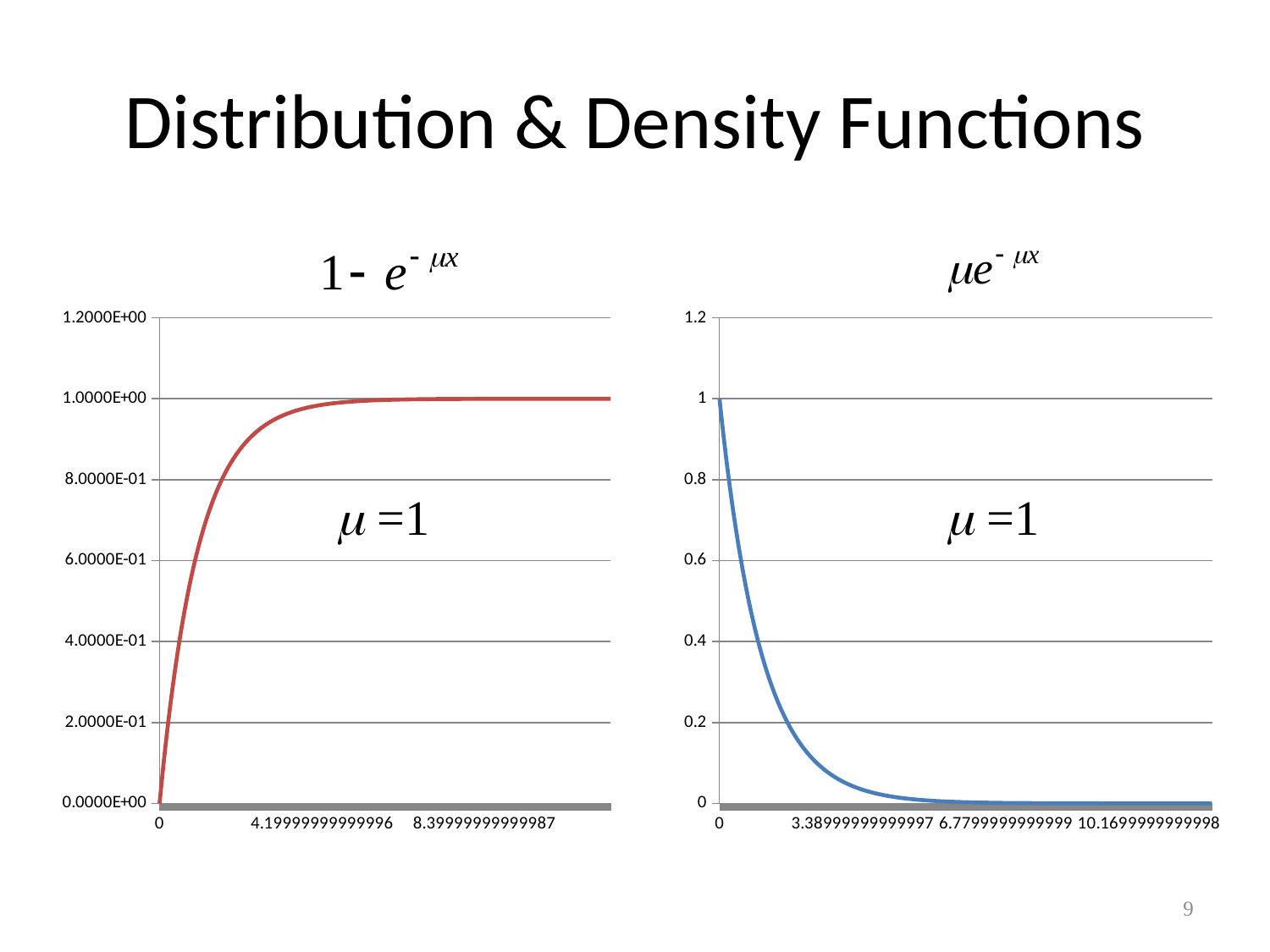
In the left chart titled 1 - e^(-μx), is the value at x = 8.39999999999987 greater or less than 8.0000E-01? greater In the right chart titled μe^(-μx), is the value at x = 6.7799999999999 greater or less than 0.2? less What value of μ is stated on both charts? μ = 1 What kind of chart is the left chart titled 1 - e^(-μx)? line chart In the left chart titled 1 - e^(-μx), do the values rise or fall as x increases? rise What is the highest value shown on the y axis of the right chart titled μe^(-μx)? 1.2 In the left chart titled 1 - e^(-μx), what is the value of the line at x = 0? 0.0000E+00 In the right chart titled μe^(-μx), is the value at x = 3.38999999999997 greater or less than 0.2? less In the right chart titled μe^(-μx), do the values rise or fall as x increases? fall What kind of chart is the right chart titled μe^(-μx)? line chart What colour is the line in the left chart titled 1 - e^(-μx)? red In the right chart titled μe^(-μx), what is the value of the line at x = 0? 1